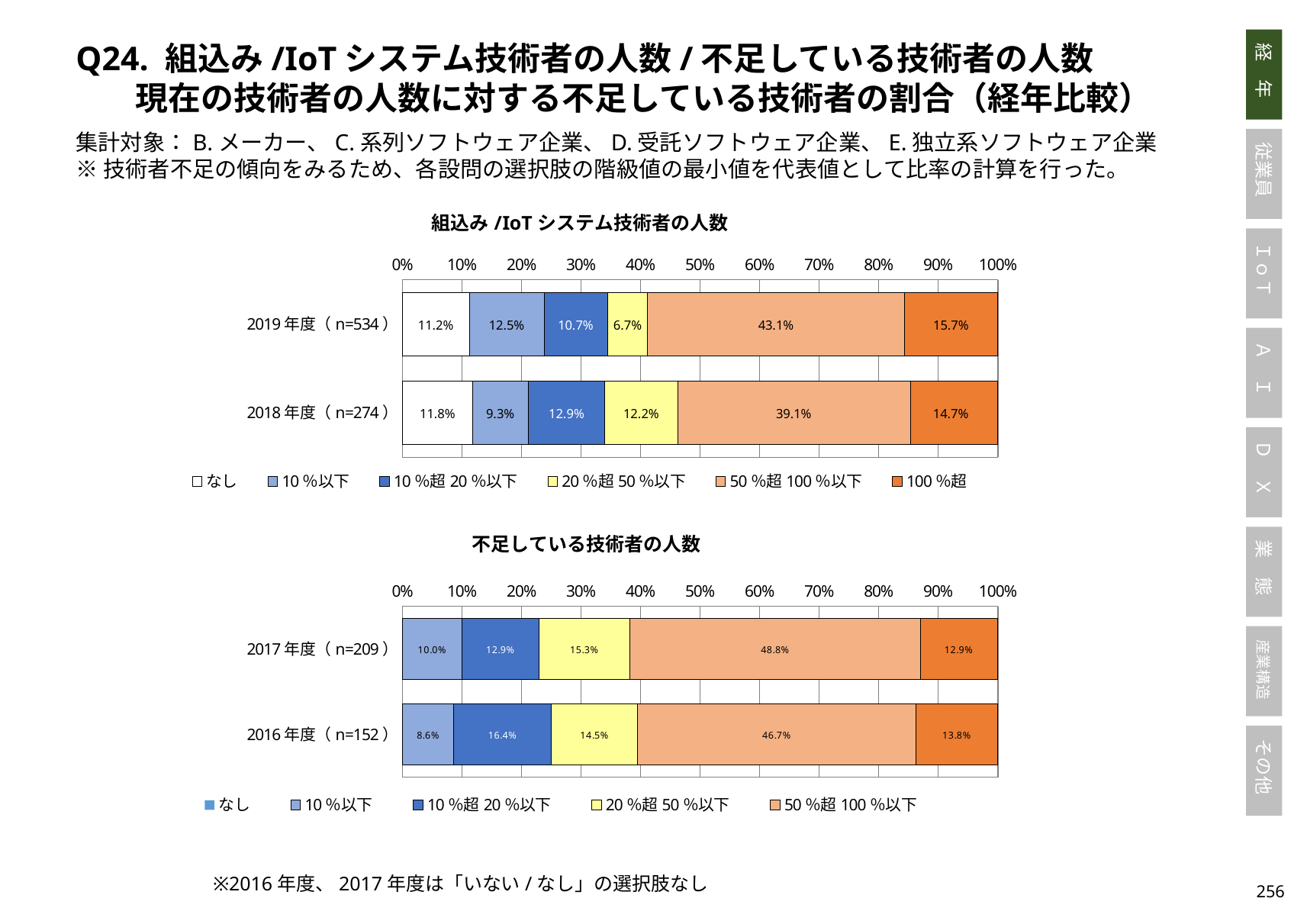
In the top chart (組込み/IoTシステム技術者の人数), what is the value for 100%超 in 2018年度? 14.7% In the top chart (組込み/IoTシステム技術者の人数), what is the value for 50%超100%以下 in 2019年度? 43.1% In the bottom chart (不足している技術者の人数), what is the largest segment value in the 2017年度 bar? 48.8% In the bottom chart (不足している技術者の人数), how many entries does the legend list? 5 In the bottom chart (不足している技術者の人数), how many year categories are plotted? 2 In the top chart (組込み/IoTシステム技術者の人数), what is the difference between the 50%超100%以下 values for 2019年度 and 2018年度? 4.0 percentage points In the top chart (組込み/IoTシステム技術者の人数), what is the value for なし in 2019年度? 11.2% In the top chart (組込み/IoTシステム技術者の人数), how many series does the legend list? 6 In the bottom chart (不足している技術者の人数), what is the largest segment value in the 2016年度 bar? 46.7% In the top chart (組込み/IoTシステム技術者の人数), what is the value for 20%超50%以下 in 2018年度? 12.2% What kind of chart is the top chart (組込み/IoTシステム技術者の人数)? Stacked bar chart In the top chart (組込み/IoTシステム技術者の人数), which year has the larger value for 10%以下, 2019年度 or 2018年度? 2019年度